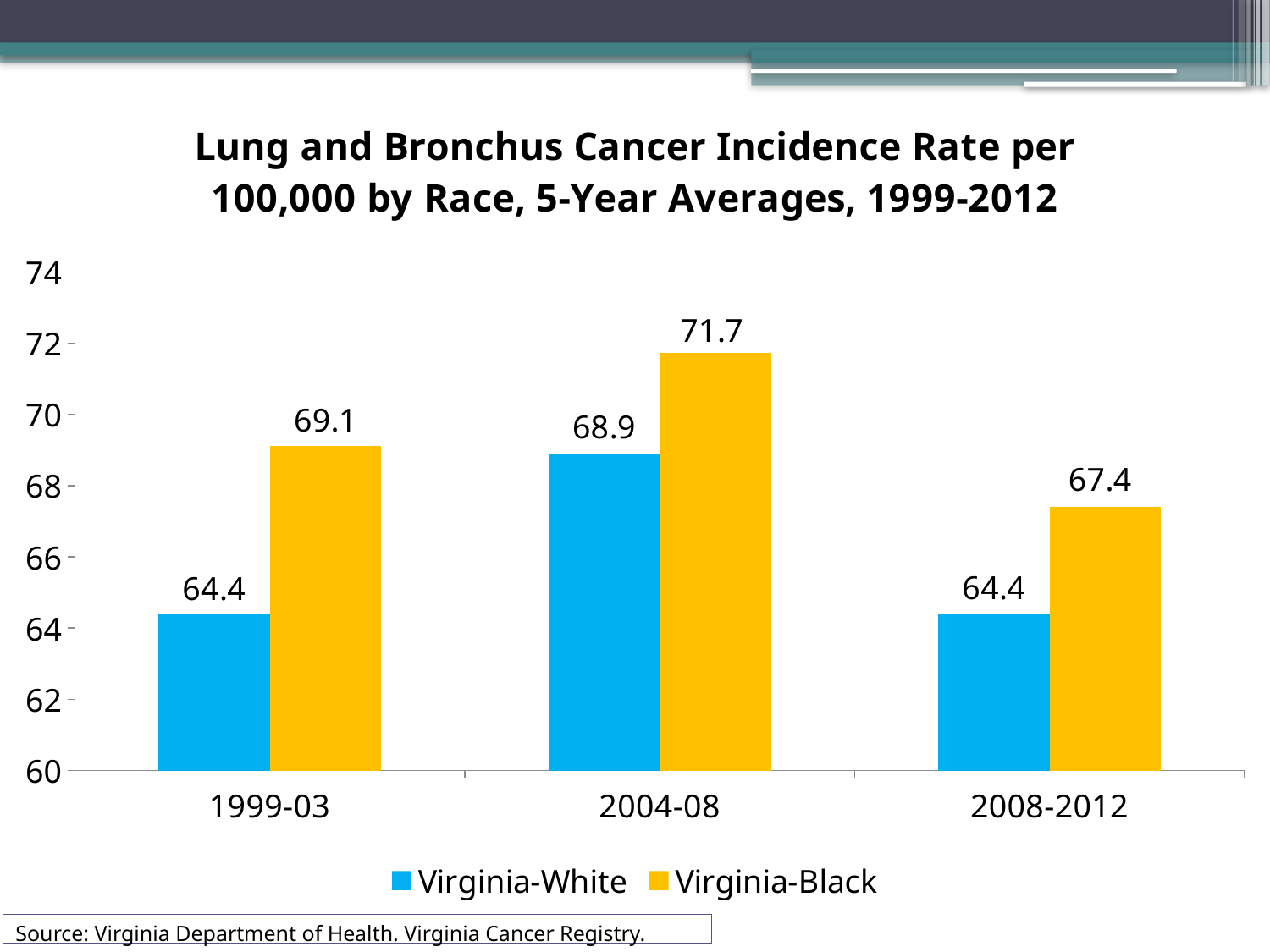
What is the Virginia-Black lung and bronchus cancer incidence rate for 2004-08? 71.7 How many series does the legend list? 2 What is the Virginia-Black incidence rate for 2008-2012? 67.4 What is the Virginia-White incidence rate for 1999-03? 64.4 Which is larger in 2008-2012, the Virginia-White rate or the Virginia-Black rate? Virginia-Black What kind of chart is shown on the slide? bar chart In which period is the Virginia-Black incidence rate lowest? 2008-2012 What is the difference between the Virginia-Black and Virginia-White rates in 1999-03? 4.7 What is the difference between the Virginia-Black and Virginia-White rates in 2004-08? 2.8 Is the Virginia-White rate for 2004-08 greater or less than 66? greater How many time periods are shown on the x axis? 3 In which period is the Virginia-Black incidence rate highest? 2004-08